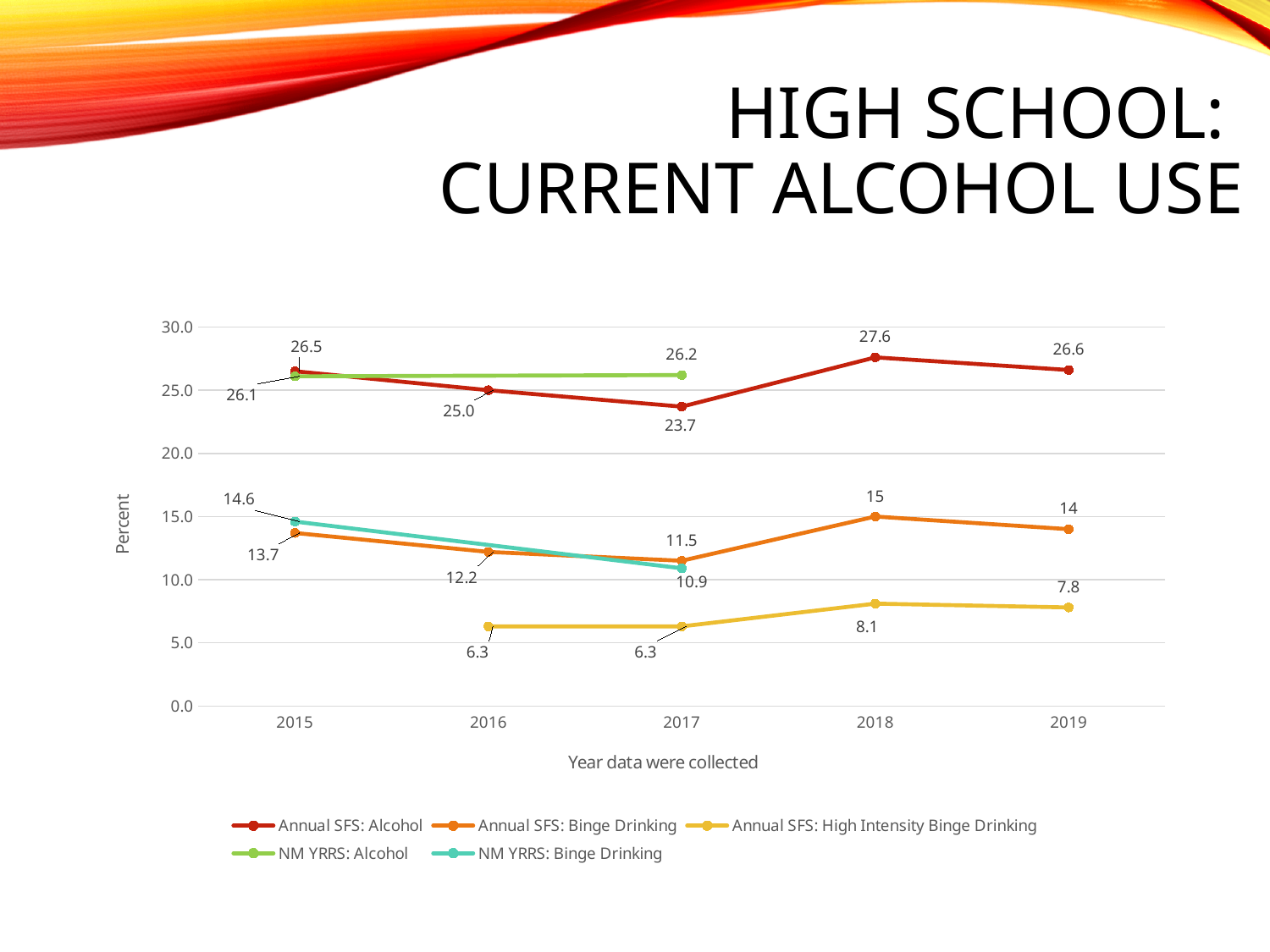
What is the value for Annual SFS: Alcohol in 2018? 27.6 What is the difference between the Annual SFS: Alcohol values for 2018 and 2017? 3.9 What is the value for Annual SFS: High Intensity Binge Drinking in 2019? 7.8 In 2015, which is larger: Annual SFS: Binge Drinking or NM YRRS: Binge Drinking? NM YRRS: Binge Drinking Is the value for Annual SFS: High Intensity Binge Drinking in 2018 greater or less than 10.0? less In which year is the Annual SFS: Alcohol series highest? 2018 What is the value for NM YRRS: Binge Drinking in 2017? 10.9 How many series does the legend list? 5 What kind of chart is shown on the slide? line chart Does the Annual SFS: Binge Drinking series rise or fall from 2015 to 2017? fall In which year is the Annual SFS: Binge Drinking series lowest? 2017 How many years are shown on the x axis? 5